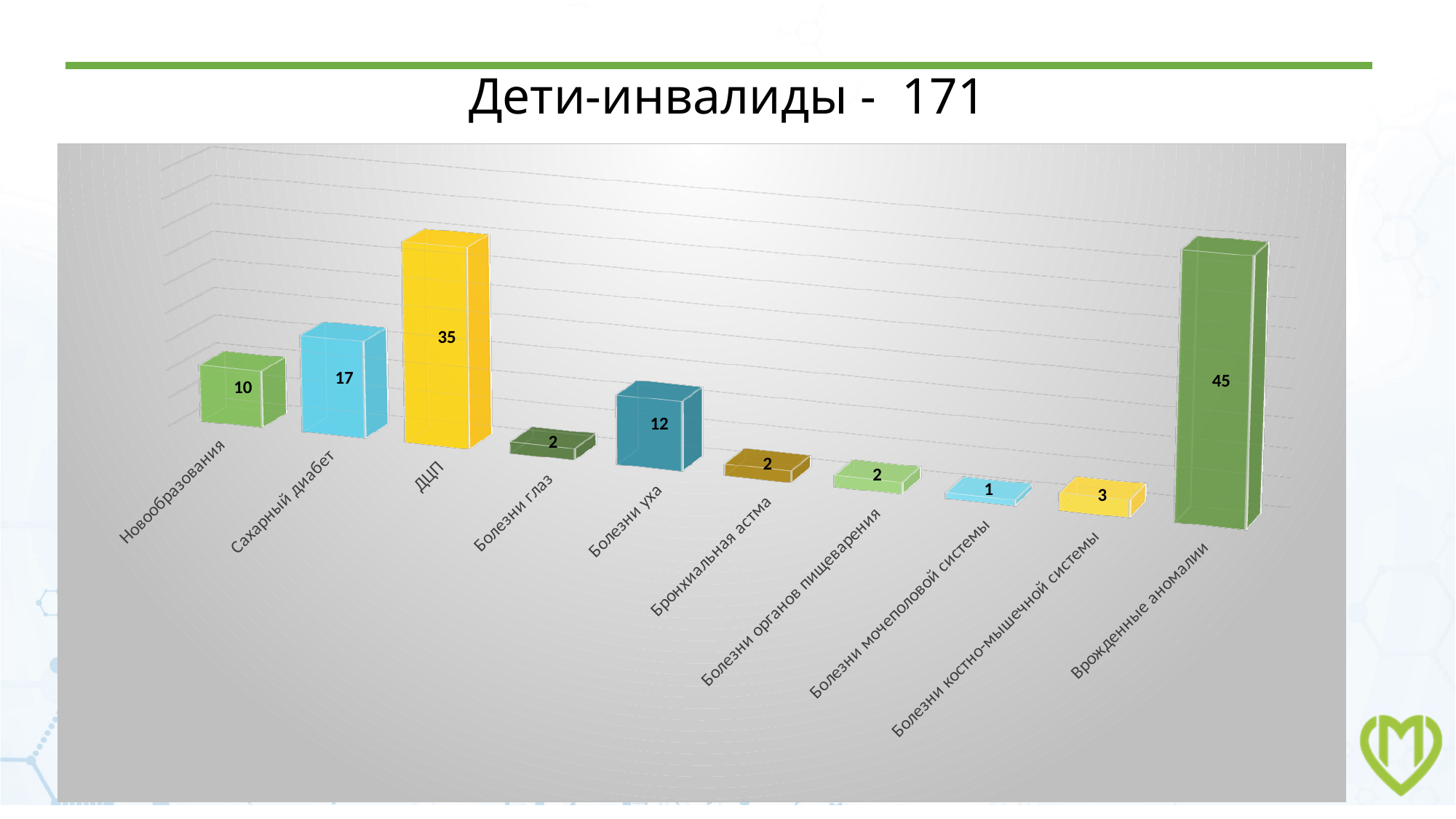
Which category has the highest value? Врожденные аномалии Which category has the lowest value? Болезни мочеполовой системы What is the value for Болезни мочеполовой системы? 1 What is the difference between the values for Врожденные аномалии and ДЦП? 10 What is the title of the slide? Дети-инвалиды - 171 What is the value for ДЦП? 35 Which is larger, the value for Сахарный диабет or the value for Болезни уха? Сахарный диабет What kind of chart is shown on the slide? Bar chart What is the value for Болезни уха? 12 What is the value for Сахарный диабет? 17 What is the value for Врожденные аномалии? 45 How many categories are shown in the chart? 10